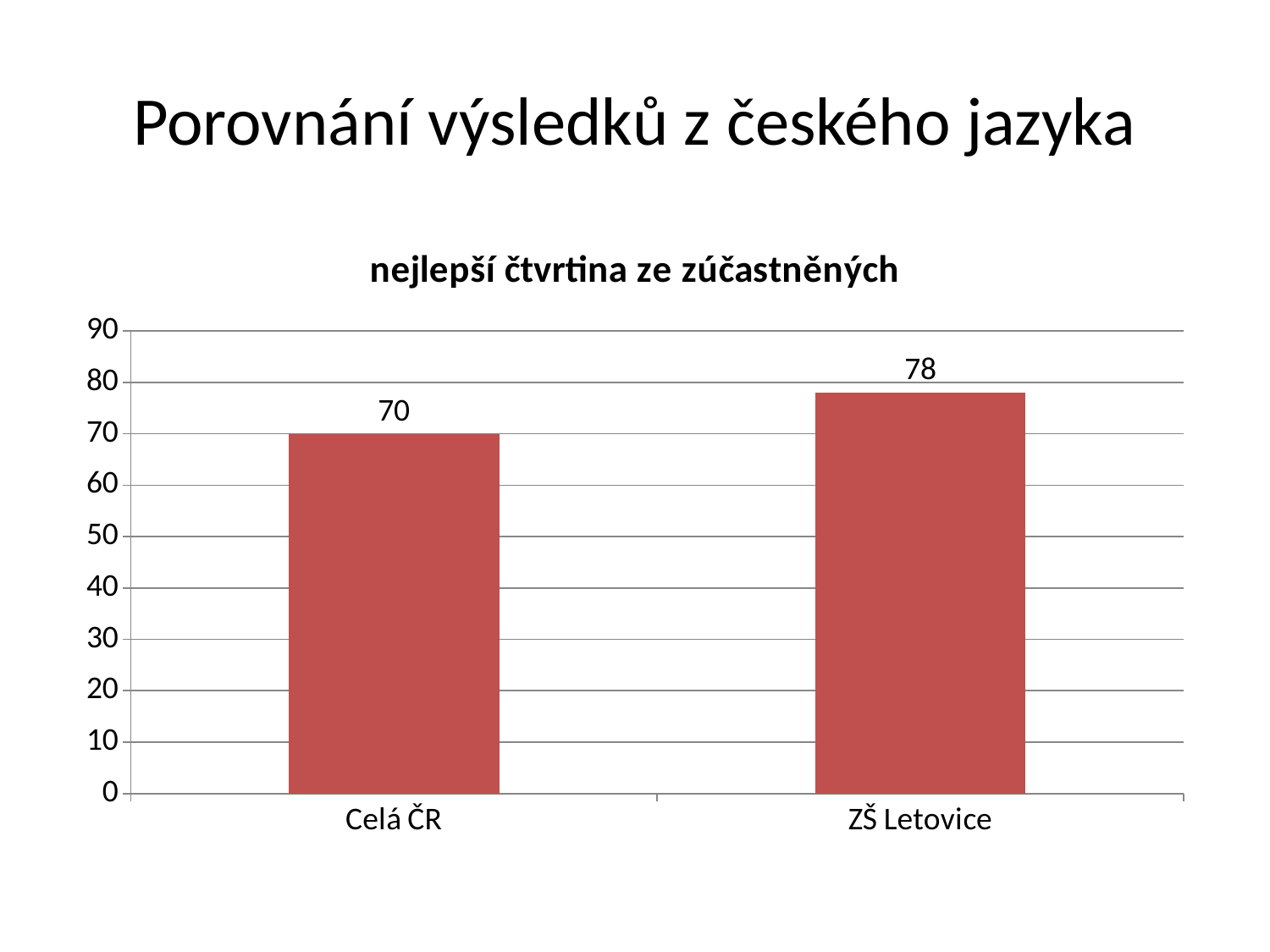
How many categories are shown on the chart? 2 What is the value for ZŠ Letovice? 78 Which category has the lowest value? Celá ČR What is the maximum value shown on the vertical axis? 90 What is the difference between the values for ZŠ Letovice and Celá ČR? 8 Is the value for Celá ČR greater or less than 60? greater Which category has the highest value? ZŠ Letovice Is the value for ZŠ Letovice greater or less than 80? less What is the title of the chart? nejlepší čtvrtina ze zúčastněných What kind of chart is shown on the slide? bar chart Which is larger, the value for Celá ČR or the value for ZŠ Letovice? ZŠ Letovice What is the value for Celá ČR? 70